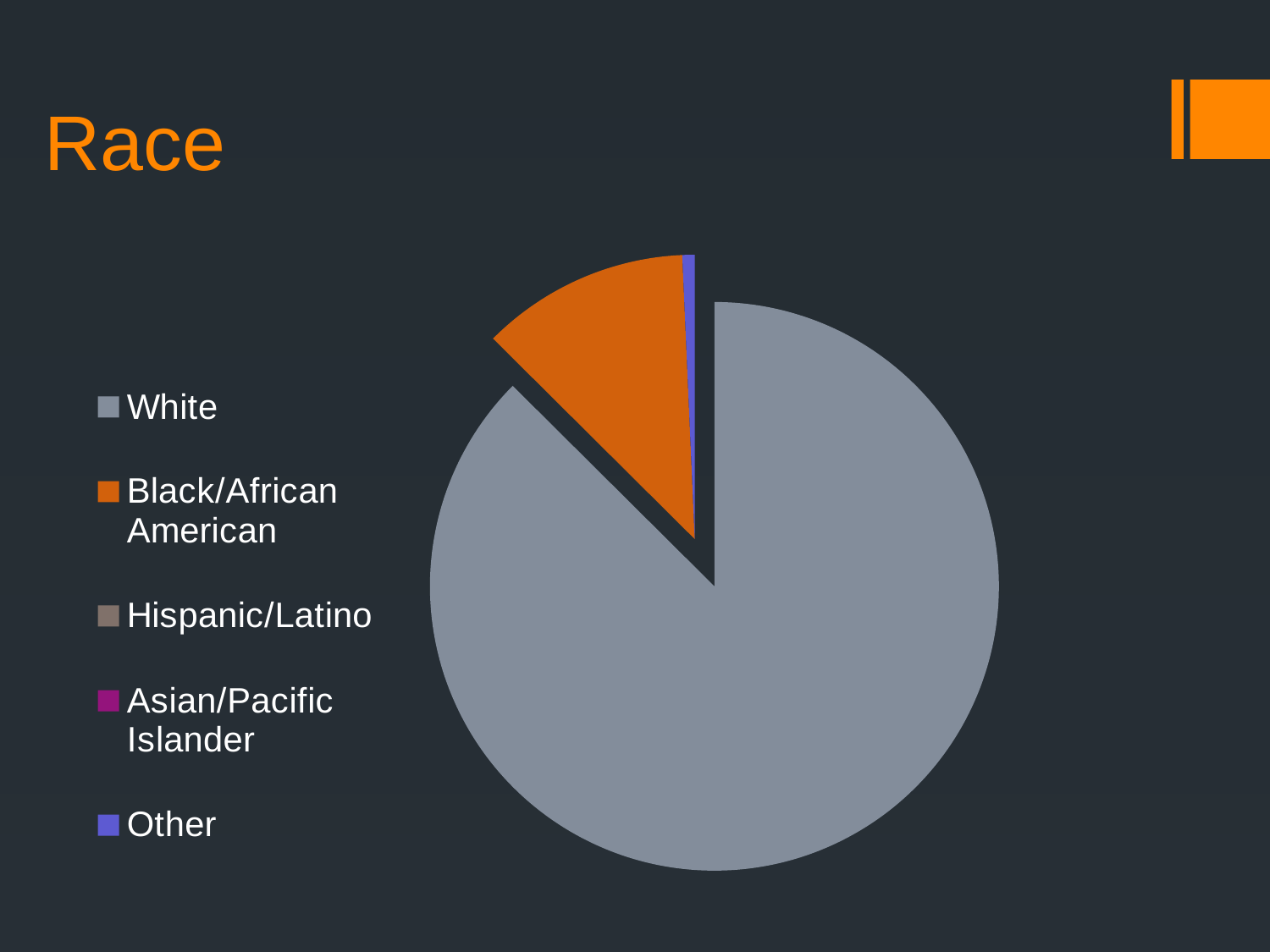
How many categories does the legend list? 5 Which category has the largest slice of the pie? White Which slice is larger, Black/African American or Other? Black/African American Does the White slice take up more or less than half of the pie? more What colour is the slice for Black/African American? orange What is the title of the chart on the slide? Race Which category has the second-largest slice of the pie? Black/African American Which slice is larger, White or Black/African American? White What kind of chart is shown on the slide? pie chart